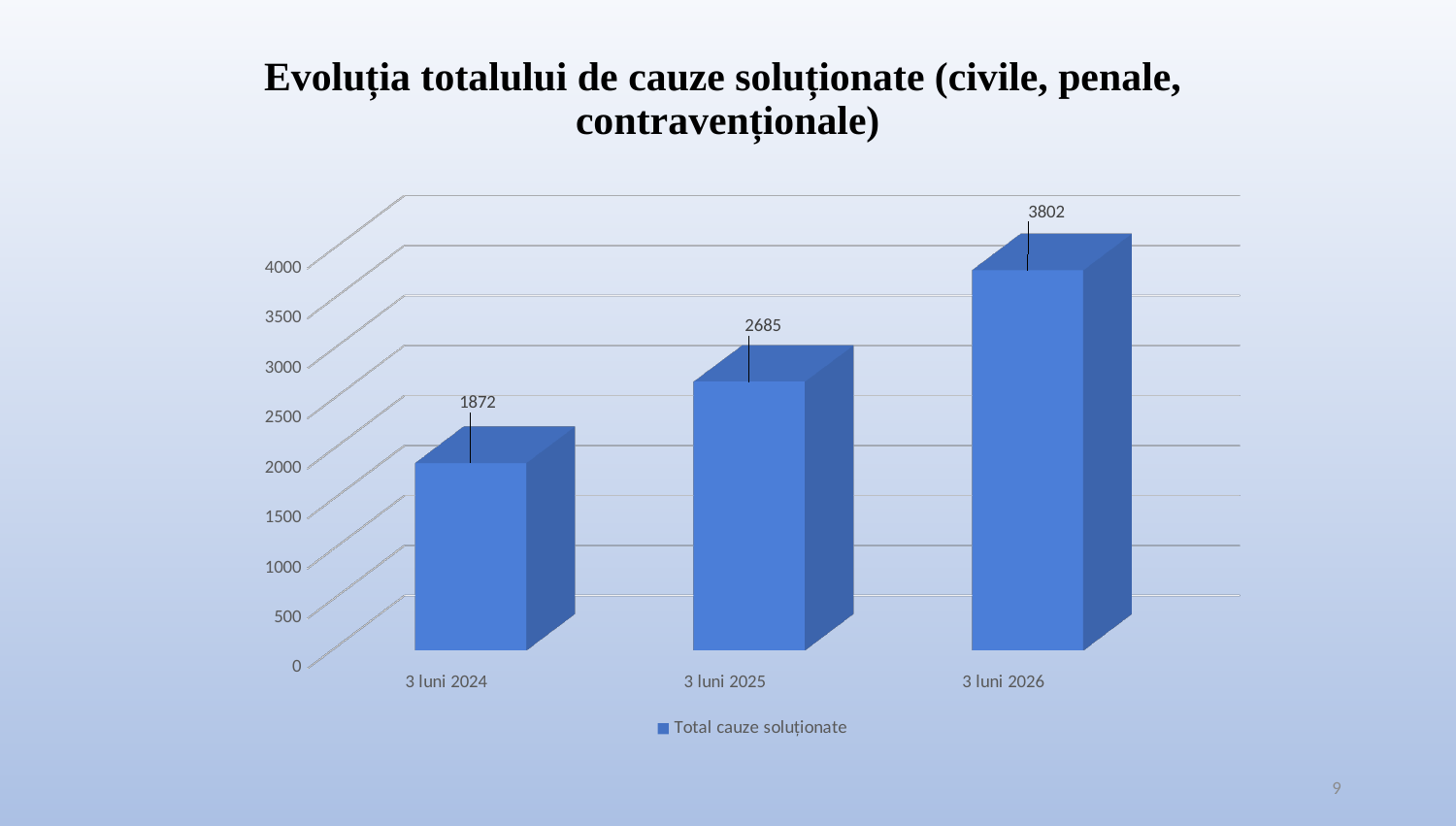
Which category has the highest value? 3 luni 2026 What is the value for 3 luni 2024? 1872 Do the values rise or fall from 3 luni 2024 to 3 luni 2026? rise What is the value for 3 luni 2025? 2685 What is the difference between the values for 3 luni 2025 and 3 luni 2024? 813 What is the value for 3 luni 2026? 3802 What is the difference between the values for 3 luni 2026 and 3 luni 2025? 1117 What kind of chart is shown on the slide? bar chart Which category has the lowest value? 3 luni 2024 Is the value for 3 luni 2026 greater or less than 3500? greater How many categories are shown on the x axis? 3 Which is larger, the value for 3 luni 2024 or the value for 3 luni 2025? 3 luni 2025